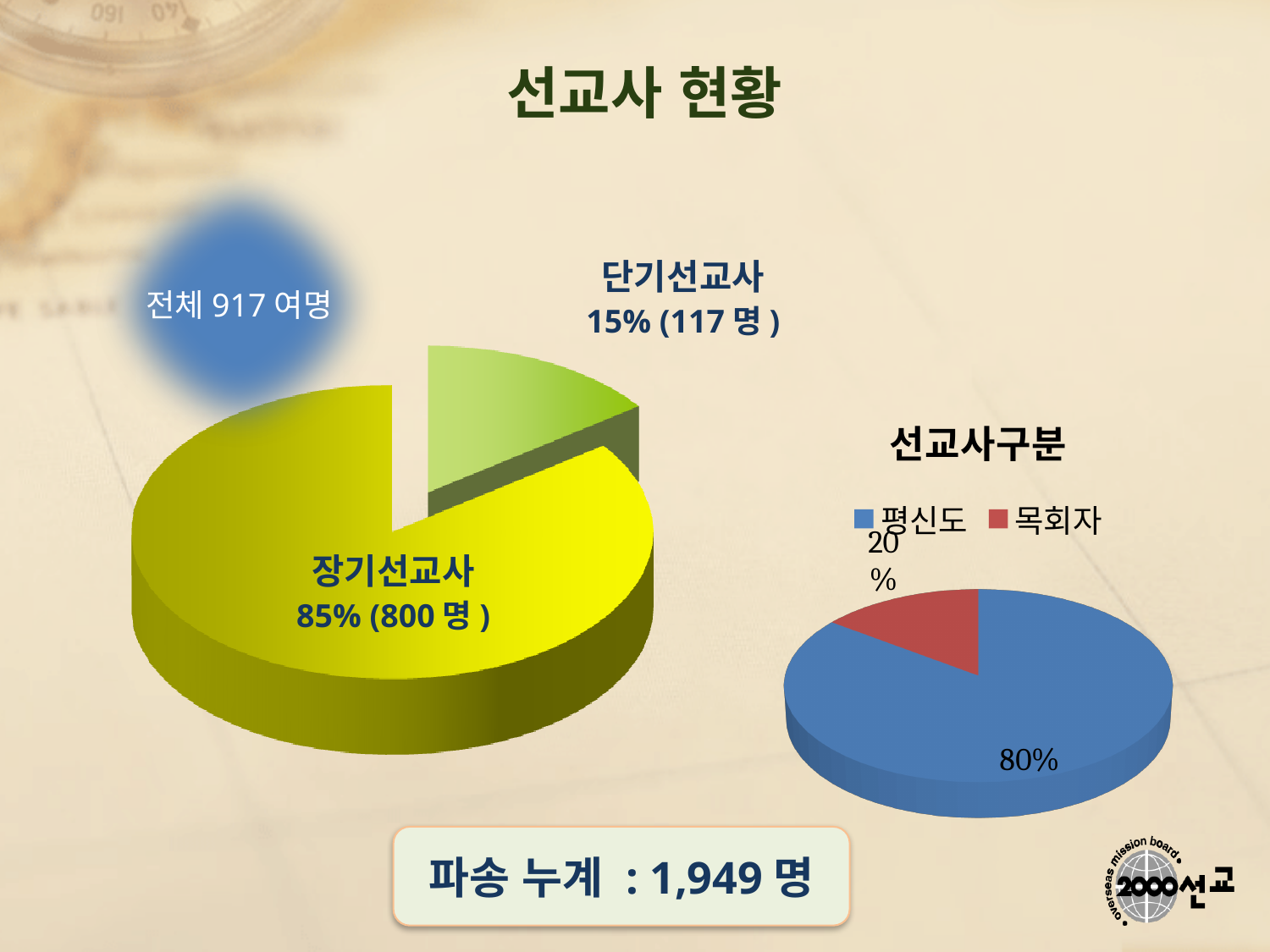
In the left pie chart, how many people are shown for 장기선교사? 800 명 In the 선교사구분 chart, what colour represents 목회자? Red In the 선교사구분 chart, what percentage is shown for 평신도? 80% In the left pie chart, which category has the smaller share? 단기선교사 In the left pie chart, how many people are shown for 단기선교사? 117 명 In the left pie chart, what percentage is shown for 장기선교사? 85% In the left pie chart, what is the difference in percentage points between 장기선교사 and 단기선교사? 70 In the 선교사구분 chart, what percentage is shown for 목회자? 20% In the left pie chart, which category has the larger share? 장기선교사 In the 선교사구분 chart, which category is larger, 평신도 or 목회자? 평신도 What type of chart is the 선교사구분 chart? Pie chart How many entries does the legend of the 선교사구분 chart list? 2